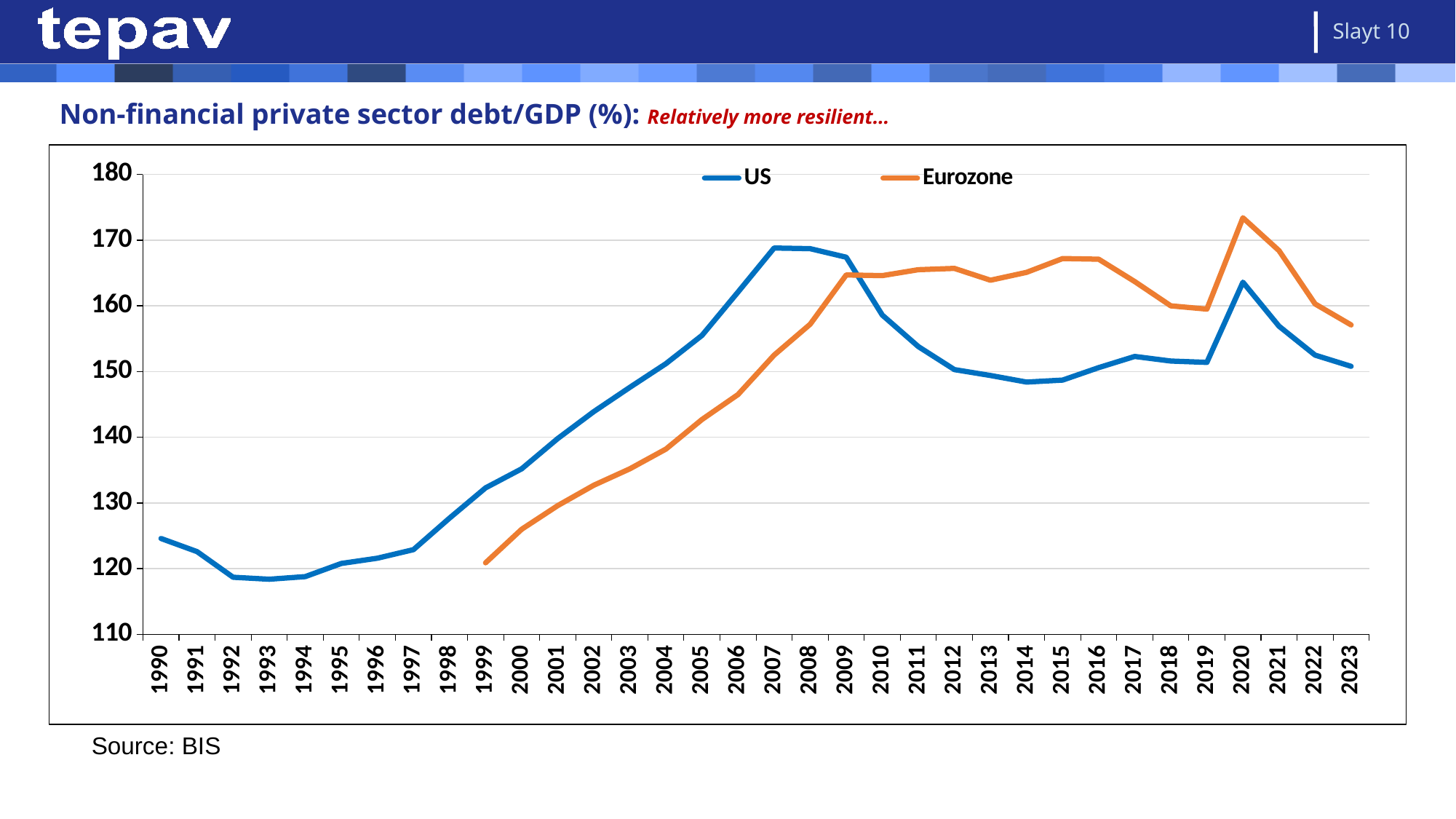
Is the value for US in 2014 greater or less than 150? less In 2015, which series has the larger value, US or Eurozone? Eurozone Is the value for US in 2007 greater or less than 160? greater Is the value for Eurozone in 2020 greater or less than 170? greater How many series does the legend list? 2 In 2005, which series has the larger value, US or Eurozone? US How many years are labelled on the x axis? 34 What kind of chart is shown on the slide? line chart In which year does the Eurozone series reach its highest value? 2020 Which series reaches the highest value on the chart, US or Eurozone? Eurozone In which year does the Eurozone series have its lowest value? 1999 Does the US series rise or fall between 1997 and 2007? rise